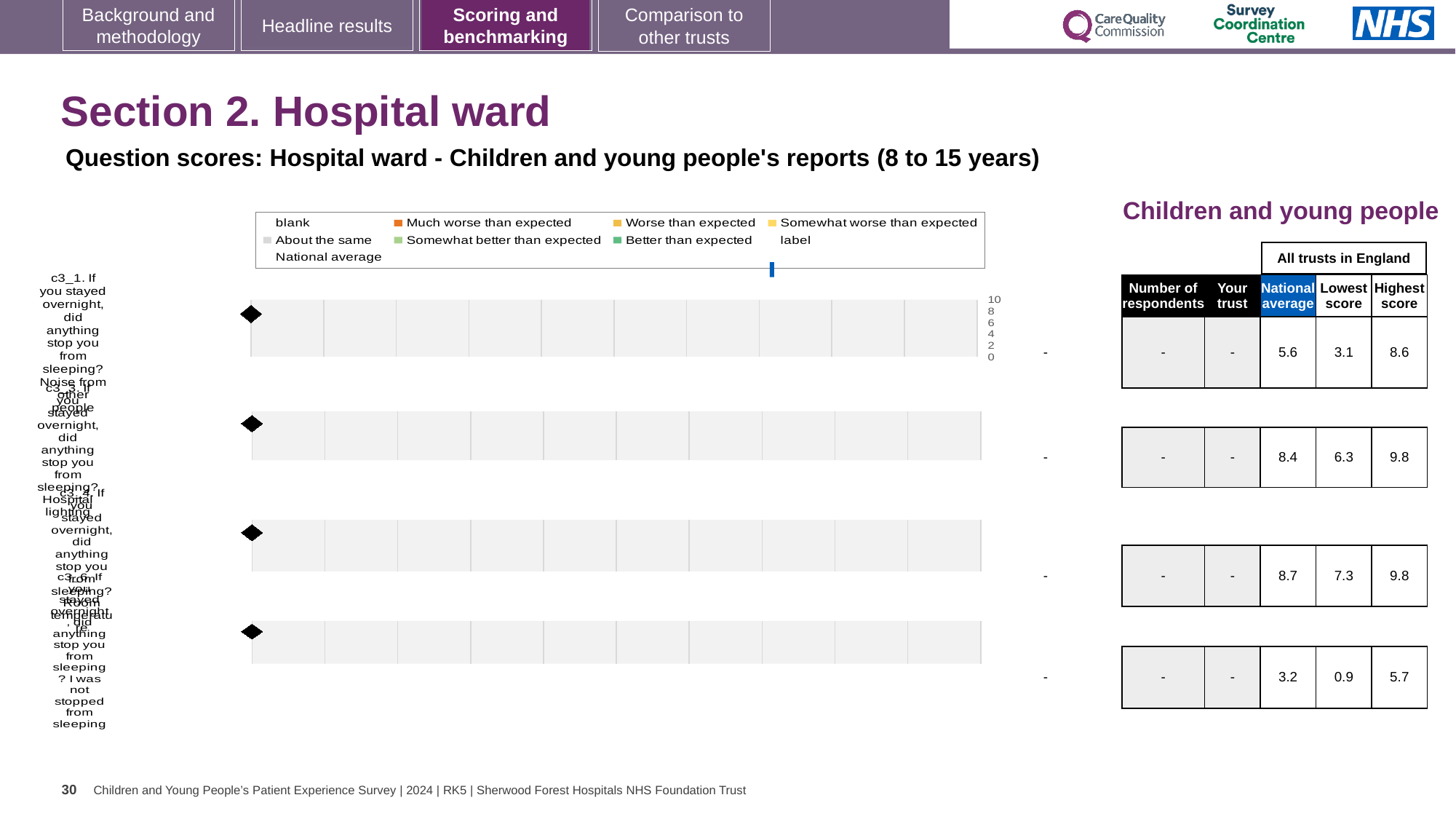
In the table beside the chart, what is the National average for the first question (c3_1, noise from other people)? 5.6 In the table beside the chart, what is the Lowest score for the fourth question (c3_6, I was not stopped from sleeping)? 0.9 Which question has the highest National average in the table beside the chart? c3_4 (hospital lighting) In the table beside the chart, what is the Highest score for the third question (c3_4, hospital lighting)? 9.8 Which question has the lowest National average in the table beside the chart? c3_6 (I was not stopped from sleeping) In the table beside the chart, what value is shown for Your trust for the first question (c3_1)? - Which has the larger National average in the table: c3_1 (noise from other people) or c3_3 (room temperature)? c3_3 (room temperature) How many question categories (rows) does the chart show? 4 What kind of chart is shown on the slide? bar chart What is the difference between the Highest score and the Lowest score for the first question (c3_1) in the table? 5.5 What is the highest tick value shown on the chart's axis? 10